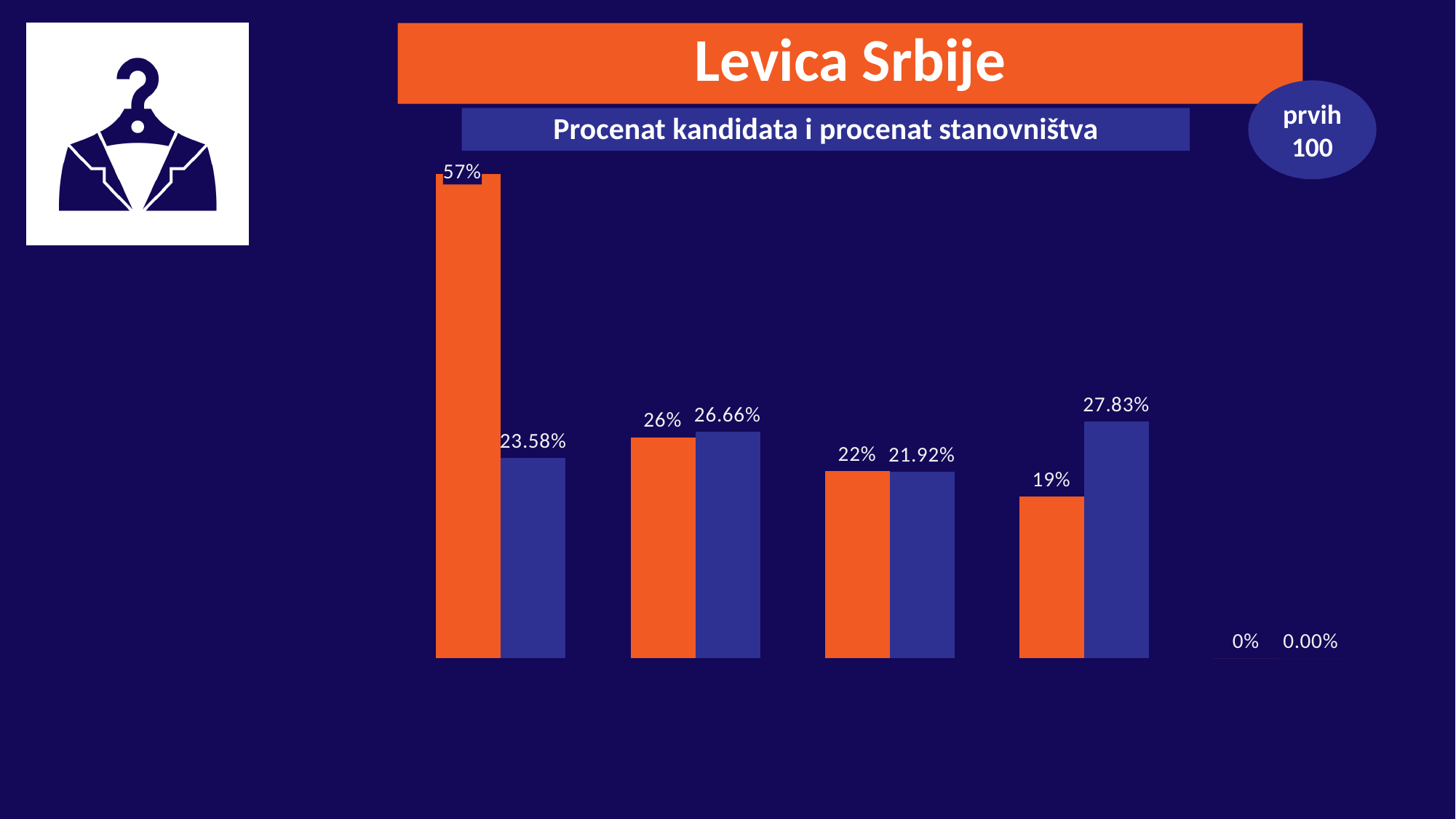
How many groups of bars are plotted in the chart? 5 What is the difference between the orange bar and the blue bar in the first group? 33.42% What is the value of the blue bar in the third group? 21.92% What is the value of the orange bar in the first (leftmost) group? 57% What is the value of the blue bar in the fourth group? 27.83% In the fourth group, which bar is larger, the orange one or the blue one? the blue one What kind of chart is shown on the slide? bar chart Do the orange bar values rise or fall from left to right across the groups? fall What is the lowest value among the blue bars? 0.00% What is the value of the blue bar in the first (leftmost) group? 23.58% Which group has the highest orange bar, and what is its value? the first group, 57% What is the value of the orange bar in the second group? 26%